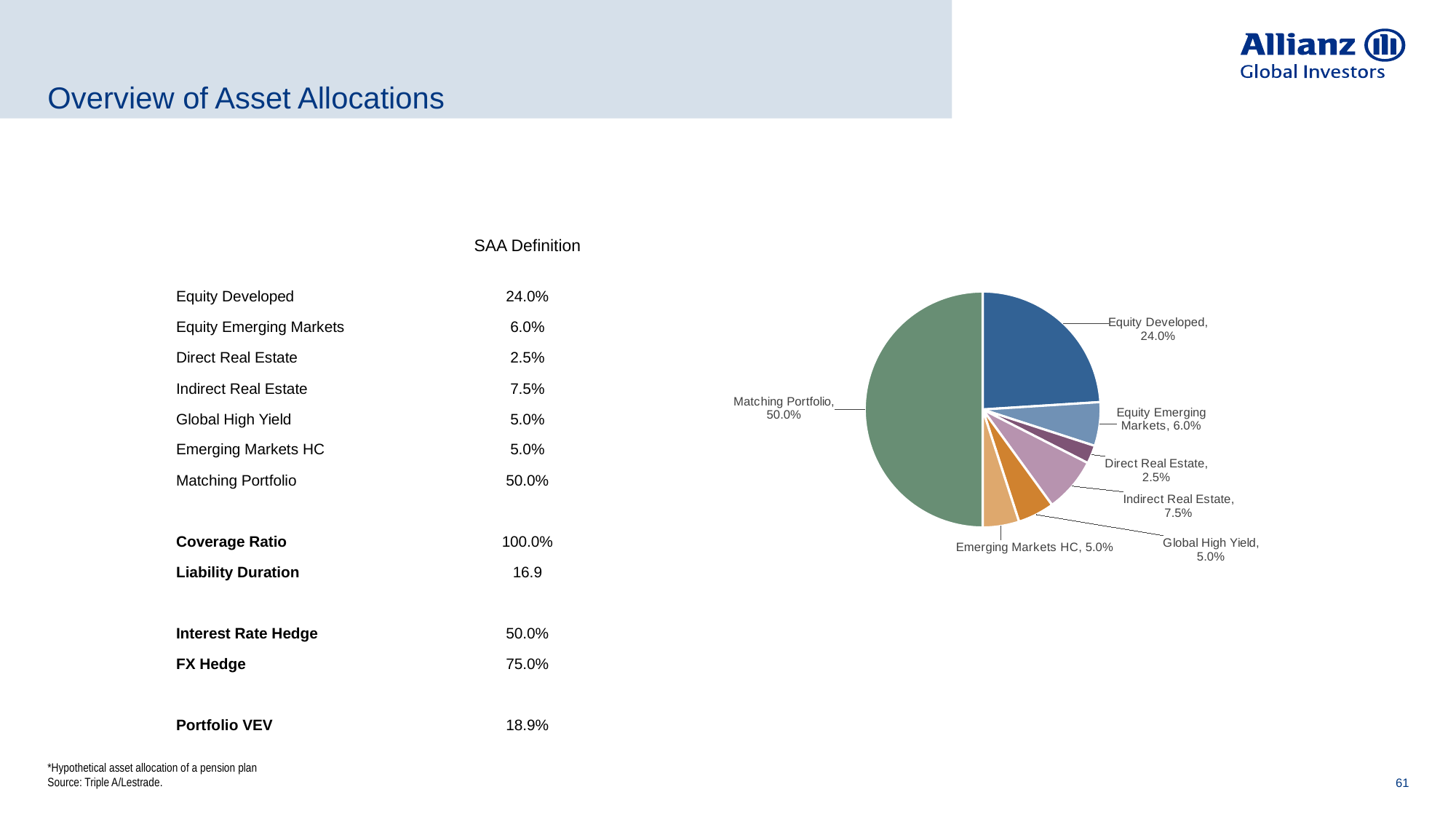
Which slice of the pie chart is the smallest? Direct Real Estate What kind of chart is shown on the slide? pie chart What is the value for Equity Developed in the pie chart? 24.0% What is the value for Direct Real Estate in the pie chart? 2.5% What is the value for Indirect Real Estate in the pie chart? 7.5% What is the difference between the Equity Developed and Equity Emerging Markets slices? 18.0% What is the combined share of Global High Yield and Emerging Markets HC in the pie chart? 10.0% Which is larger in the pie chart, Indirect Real Estate or Global High Yield? Indirect Real Estate What colour is the Matching Portfolio slice in the pie chart? green What share of the pie does Matching Portfolio represent? 50.0% Which slice of the pie chart is the largest? Matching Portfolio How many slices does the pie chart have? 7